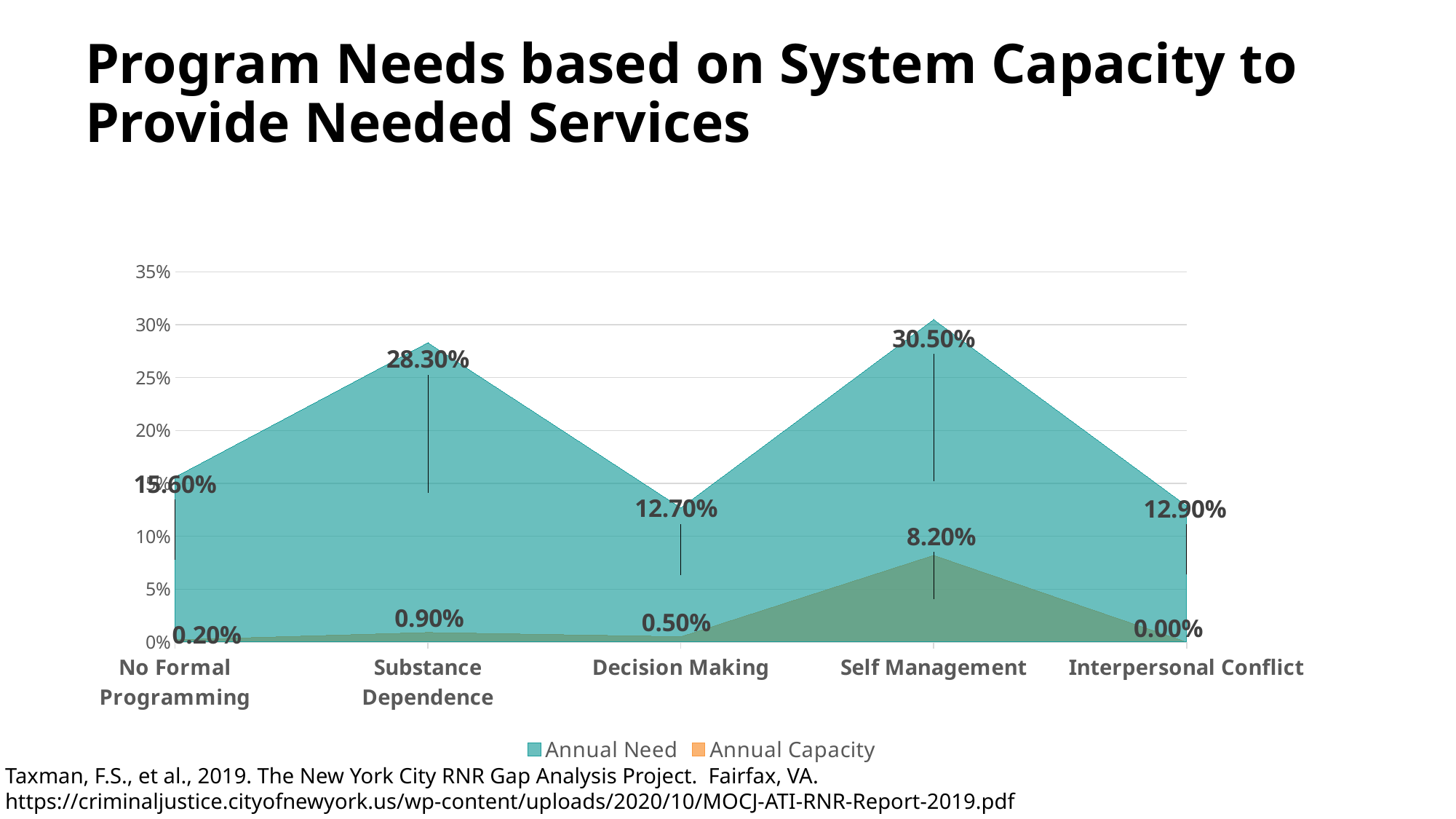
What is the Annual Need value for Decision Making? 12.70% What type of chart is shown on the slide? Area chart Which category has the highest Annual Need? Self Management How many categories are shown on the x axis? 5 What is the difference between Annual Need and Annual Capacity for Self Management? 22.30% What is the Annual Need value for Substance Dependence? 28.30% Which is larger, the Annual Need for Substance Dependence or the Annual Need for No Formal Programming? Substance Dependence What is the Annual Capacity value for Interpersonal Conflict? 0.00% Is the Annual Need value for Self Management greater or less than 30%? greater Which category has the lowest Annual Capacity? Interpersonal Conflict What is the Annual Capacity value for Self Management? 8.20% How many series does the legend list? 2